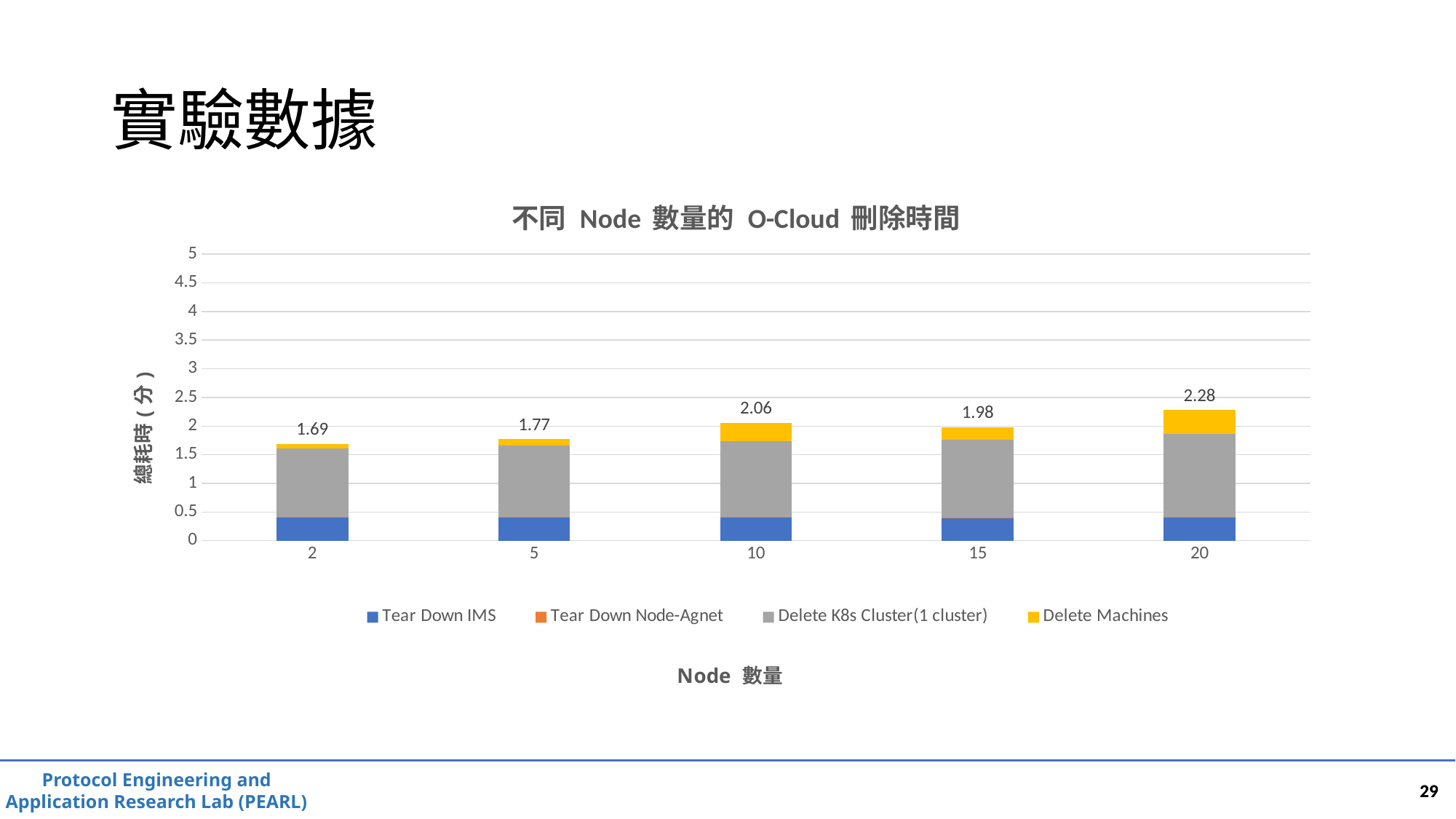
How many node-count categories are shown on the x axis? 5 What kind of chart is shown on the slide? Stacked bar chart Which node count has the lowest total deletion time? 2 What is the total deletion time labelled for 2 nodes? 1.69 Which has a larger total deletion time, 10 nodes or 15 nodes? 10 nodes Which series is shown in yellow in the legend? Delete Machines Is the Delete K8s Cluster(1 cluster) segment for 20 nodes greater or less than 1? greater How many series does the legend list? 4 What is the total deletion time labelled for 10 nodes? 2.06 What is the total deletion time labelled for 20 nodes? 2.28 Which node count has the highest total deletion time? 20 What is the difference between the total deletion time for 20 nodes and for 2 nodes? 0.59